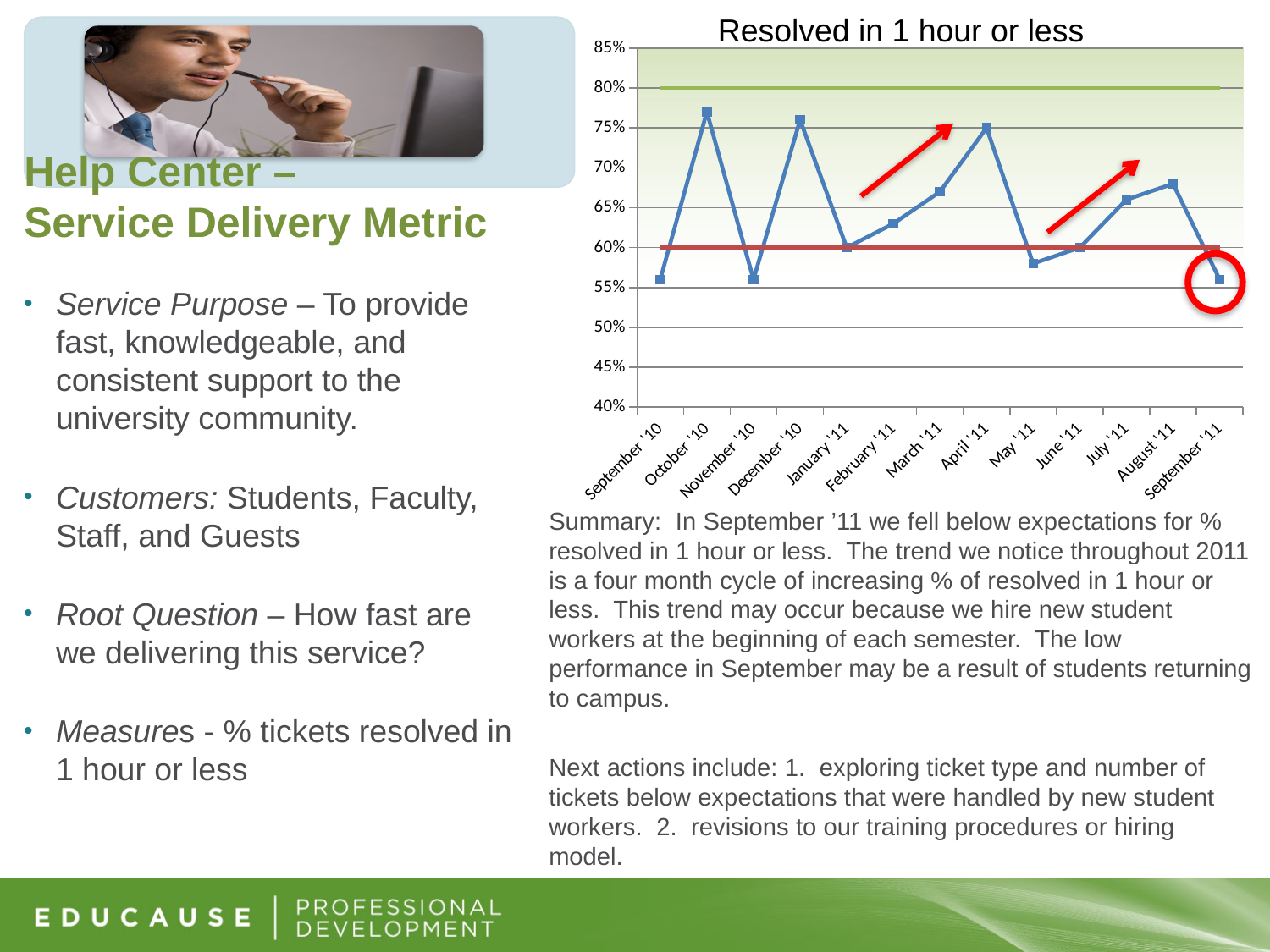
Which month has the higher value, September '10 or October '10? October '10 What is the title of the chart? Resolved in 1 hour or less How many months are plotted along the x axis of the chart? 13 Is the value for March '11 greater or less than 65%? greater Which month has the higher value, April '11 or May '11? April '11 Is the value for September '10 greater or less than 60%? less What kind of chart is shown on the slide? line chart Is the value for August '11 greater or less than 70%? less Do the values rise or fall from January '11 to April '11? rise At what percentage is the green horizontal reference line drawn on the chart? 80%